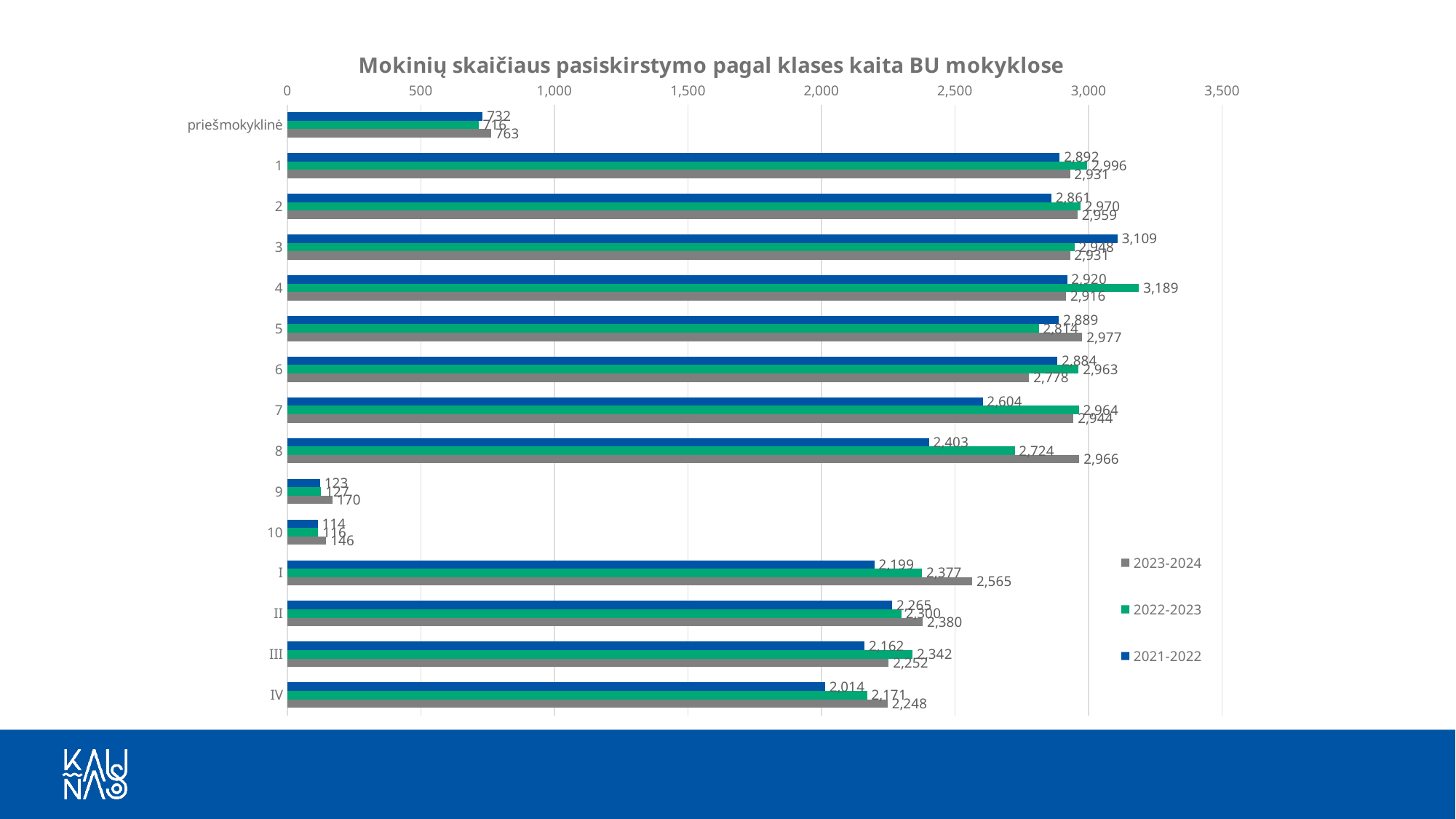
How many series does the legend list? 3 What kind of chart is shown on the slide? bar chart For class I, which is larger: the 2023-2024 value or the 2022-2023 value? 2023-2024 What is the 2023-2024 value for class 8? 2,966 Which category has the lowest 2021-2022 value? 10 For class 8, what is the difference between the 2023-2024 value and the 2021-2022 value? 563 What is the 2021-2022 value for class 3? 3,109 What is the 2022-2023 value for class 4? 3,189 How many class categories are shown on the vertical axis? 15 Across classes I, II, III and IV, do the 2023-2024 values rise or fall? fall Which category has the highest 2022-2023 value? 4 What is the 2023-2024 value for priešmokyklinė? 763